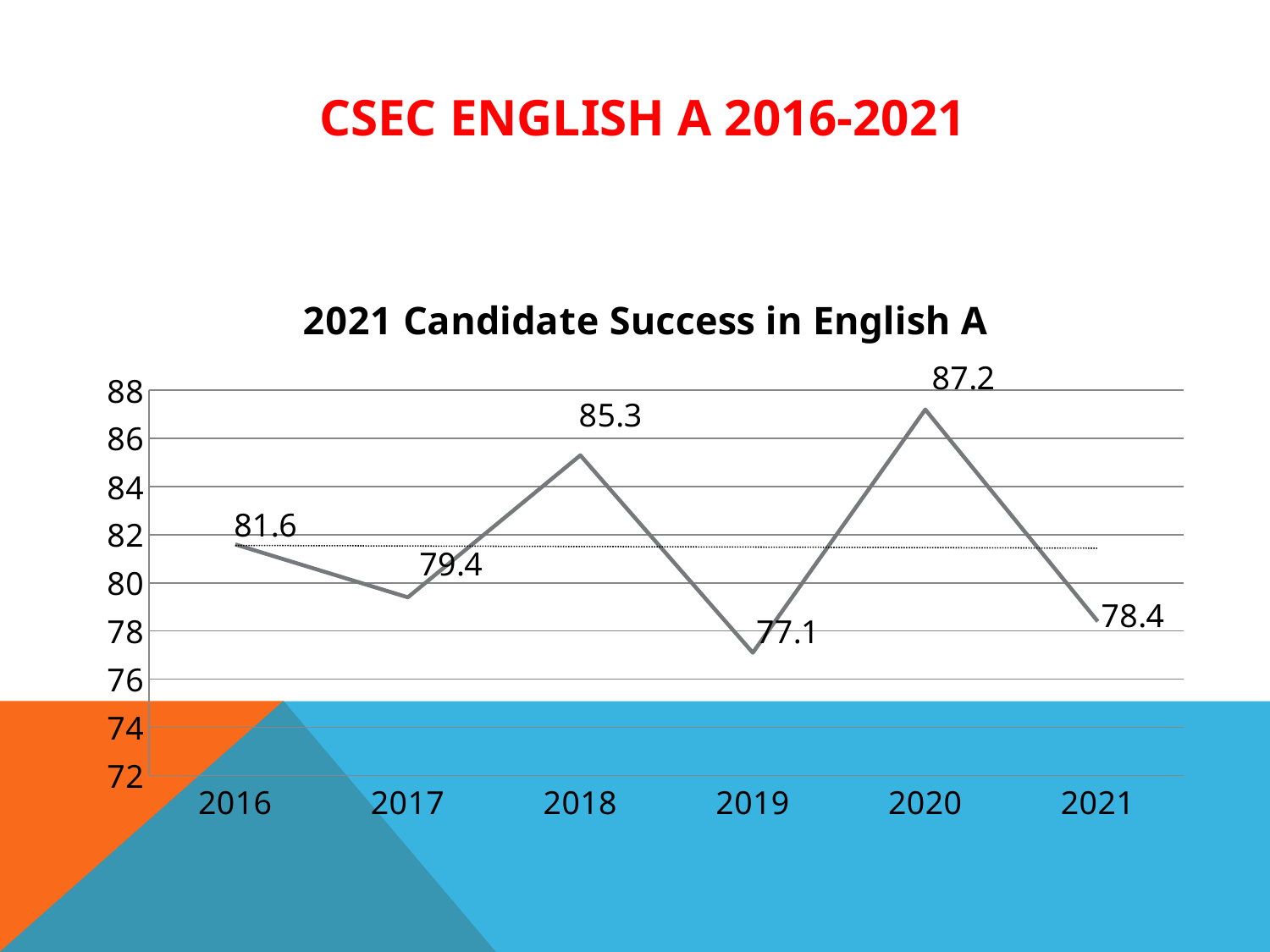
What is the difference between the values for 2020 and 2019? 10.1 What is the value for 2018? 85.3 What kind of chart is shown? line chart Which is larger, the value for 2018 or the value for 2021? 2018 Is the value for 2019 greater or less than 80? less What is the value for 2021? 78.4 How many years are plotted on the chart? 6 What is the value for 2016? 81.6 What is the difference between the values for 2016 and 2017? 2.2 Which year has the lowest value? 2019 Which year has the highest value? 2020 What is the title of the chart? 2021 Candidate Success in English A